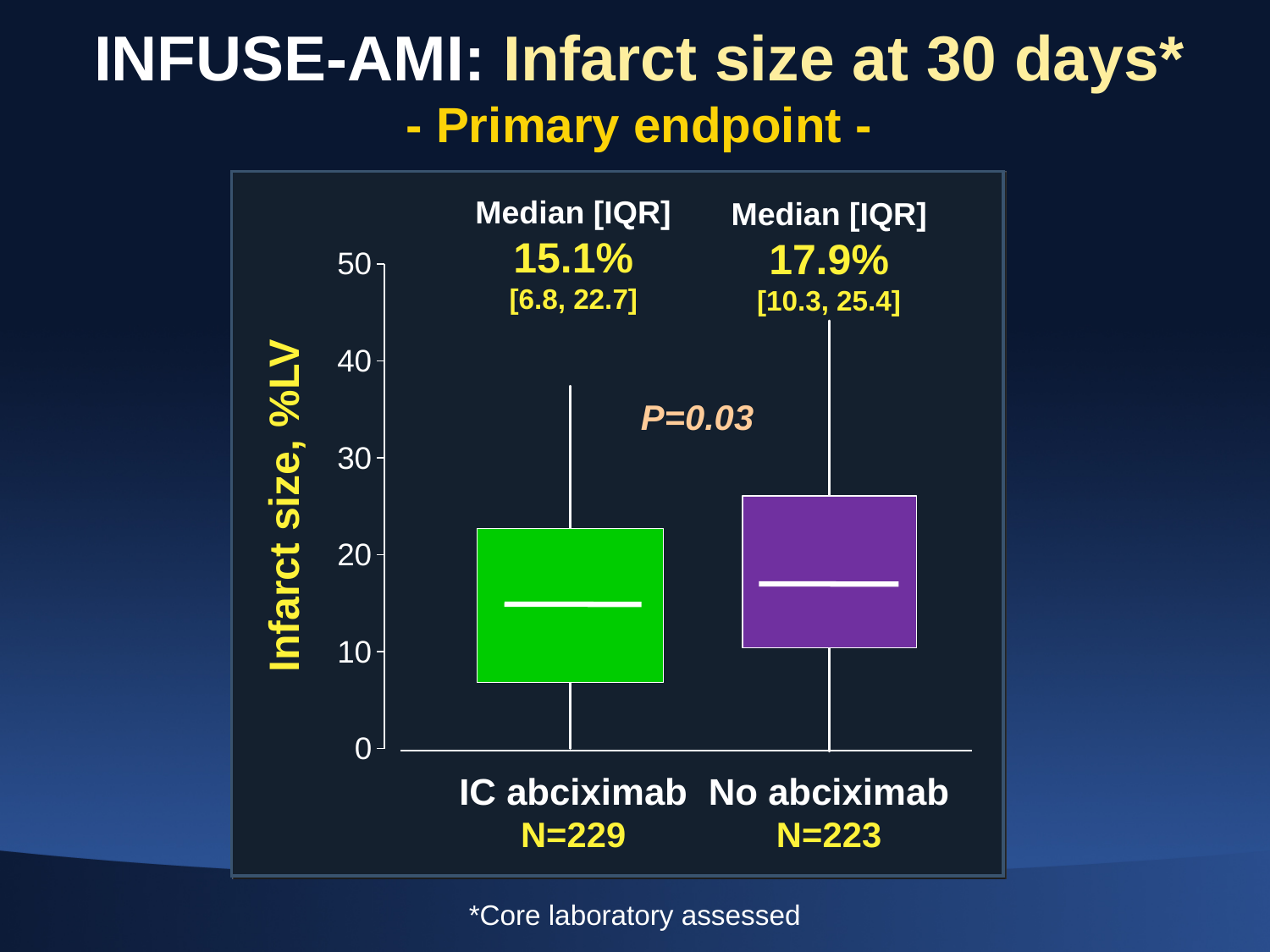
How many patients (N) are in the No abciximab group? N=223 Which group has the higher median infarct size? No abciximab Which group has the lower median infarct size? IC abciximab What is the interquartile range shown for the No abciximab group? [10.3, 25.4] What is the interquartile range shown for the IC abciximab group? [6.8, 22.7] How many groups are plotted on the chart? 2 What is the median infarct size for the IC abciximab group? 15.1% Is the median infarct size for the IC abciximab group greater or less than 20? less What is the P value shown on the chart? P=0.03 What kind of chart is shown on the slide? Box plot What is the difference between the median infarct sizes of the No abciximab and IC abciximab groups? 2.8% What is the median infarct size for the No abciximab group? 17.9%